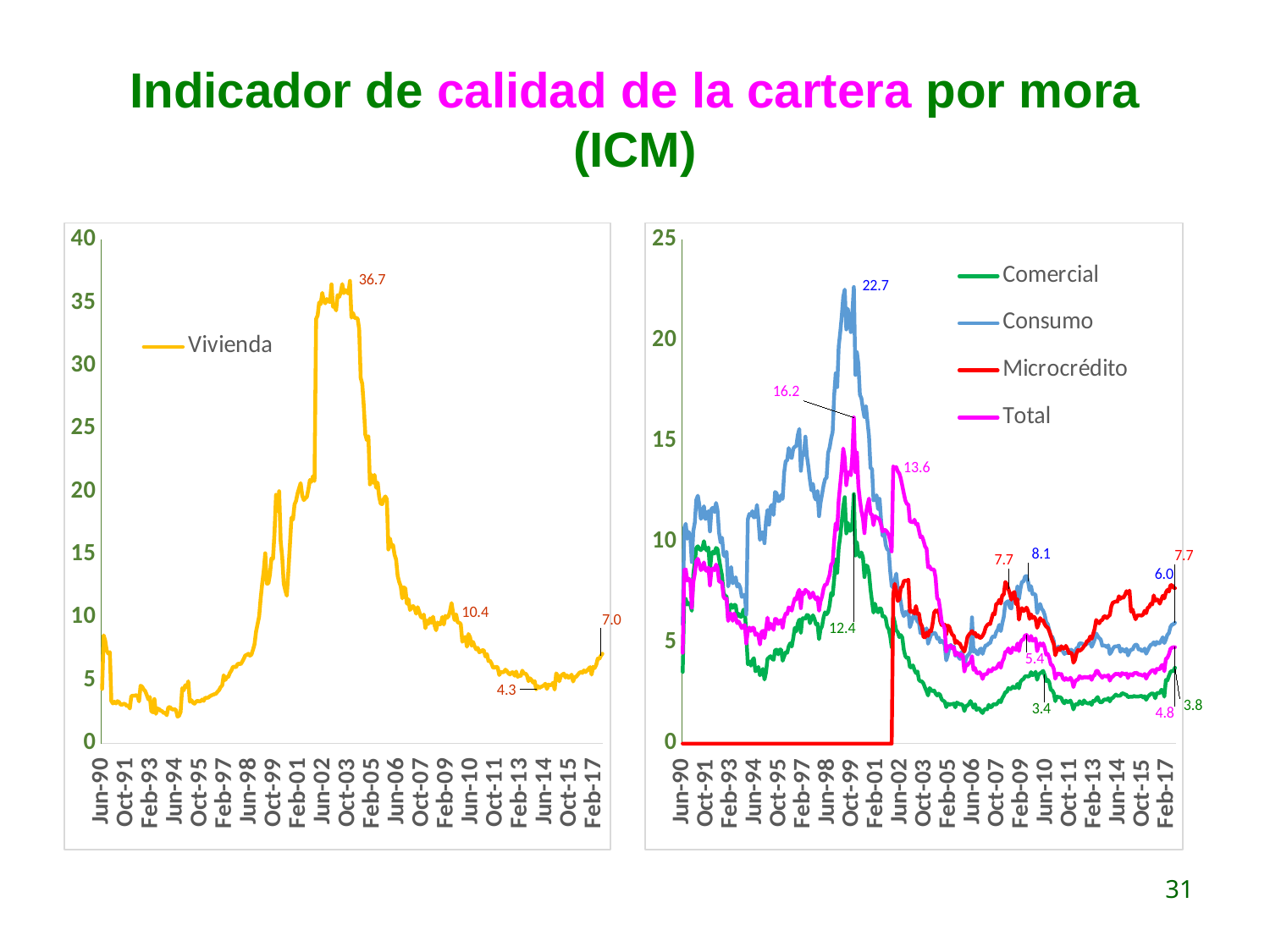
What is the name of the series shown in the legend of the left chart? Vivienda In the right chart, what is the final labeled value for Comercial? 3.8 In the left chart, what is the last labeled value for Vivienda at the right end of the series? 7.0 In the right chart, which series has the highest final labeled value? Microcrédito In the left chart, is the value for Vivienda around Oct-03 greater or less than 30? greater How many series does the legend of the right chart list? 4 In the right chart, what is the difference between the final labeled values of Microcrédito (7.7) and Comercial (3.8)? 3.9 In the left chart, what is the lowest labeled value for Vivienda? 4.3 In the right chart, what is the peak value labeled for Consumo? 22.7 What kind of chart is the left chart (Vivienda)? line chart In the left chart, what is the peak value labeled for Vivienda? 36.7 In the right chart, which has the larger final labeled value: Consumo or Total? Consumo